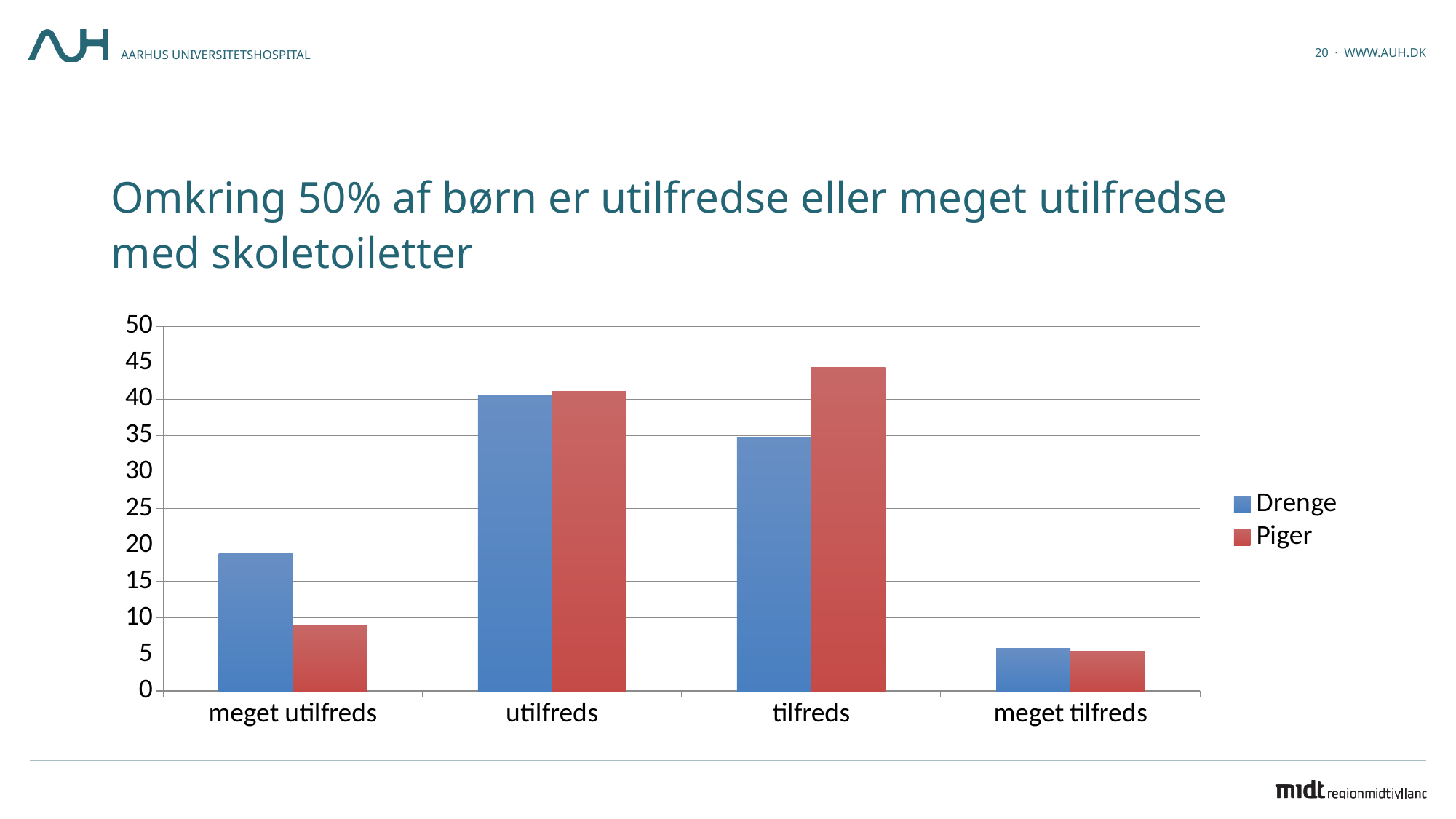
What kind of chart is shown on the slide? bar chart Is the Piger value for 'meget utilfreds' greater or less than 10? less How many series does the legend list? 2 For 'tilfreds', which is larger: Drenge or Piger? Piger For which category is the Drenge value highest? utilfreds Which series are listed in the legend? Drenge, Piger Is the Drenge value for 'meget utilfreds' greater or less than 15? greater For which category is the Piger value lowest? meget tilfreds For 'meget utilfreds', which is larger: Drenge or Piger? Drenge For which category is the Piger value highest? tilfreds How many categories are shown on the x axis? 4 For which category is the Drenge value lowest? meget tilfreds